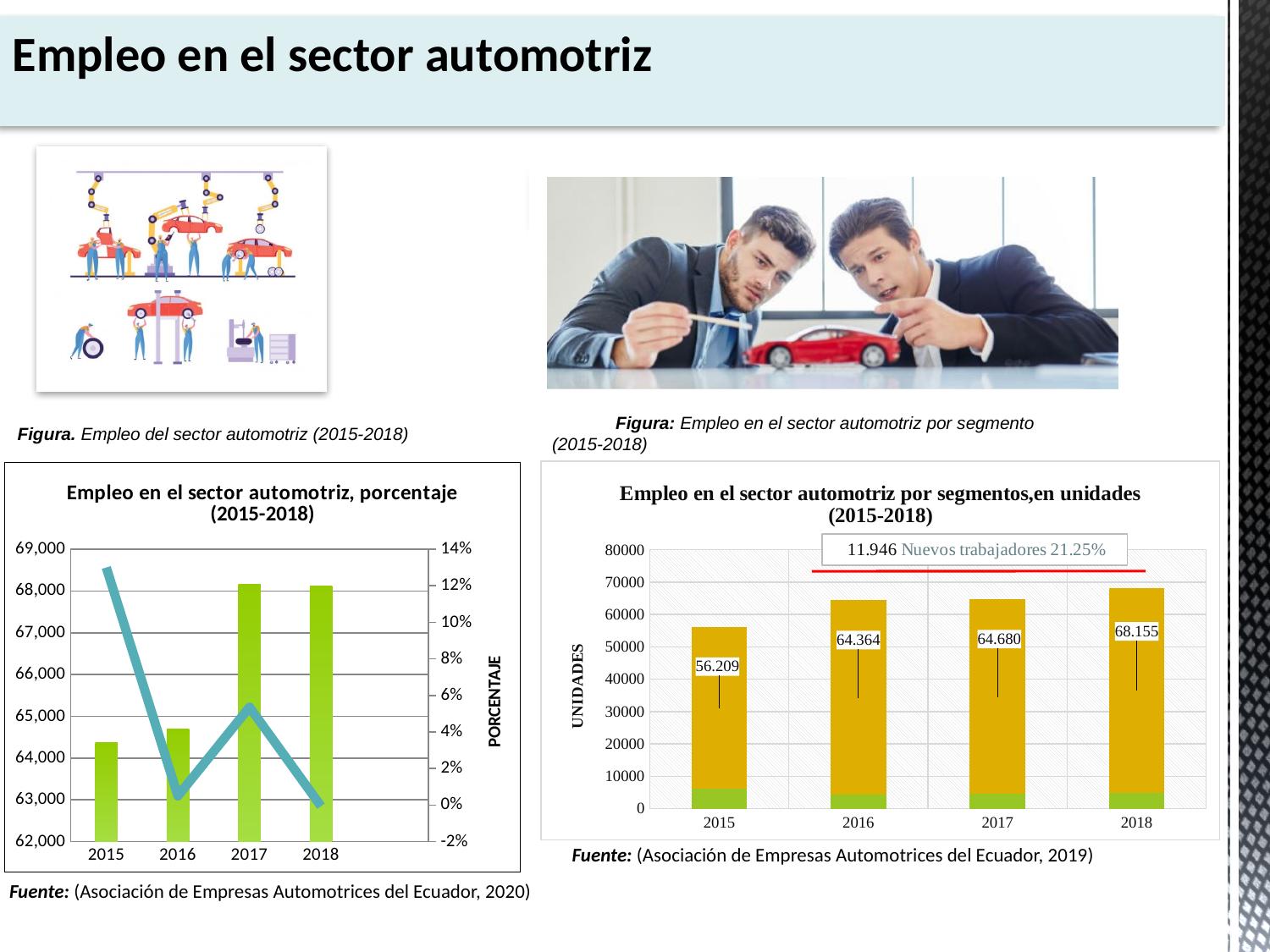
What kind of chart is the chart titled 'Empleo en el sector automotriz por segmentos, en unidades (2015-2018)'? bar chart In the chart 'Empleo en el sector automotriz, porcentaje (2015-2018)', is the bar for 2015 greater or less than 65,000? less In the chart 'Empleo en el sector automotriz por segmentos, en unidades (2015-2018)', what is the difference between the labelled values for 2018 and 2015? 11.946 In the chart 'Empleo en el sector automotriz, porcentaje (2015-2018)', is the line value for 2015 greater or less than 10%? greater How many years are shown on the x axis of the chart 'Empleo en el sector automotriz por segmentos, en unidades (2015-2018)'? 4 In the chart 'Empleo en el sector automotriz por segmentos, en unidades (2015-2018)', what value is labelled for 2015? 56.209 In the chart 'Empleo en el sector automotriz por segmentos, en unidades (2015-2018)', which year has the larger labelled value, 2016 or 2017? 2017 In the chart 'Empleo en el sector automotriz por segmentos, en unidades (2015-2018)', what value is labelled for 2018? 68.155 What is the label on the vertical axis of the chart 'Empleo en el sector automotriz por segmentos, en unidades (2015-2018)'? UNIDADES In the chart 'Empleo en el sector automotriz, porcentaje (2015-2018)', is the bar for 2017 greater or less than 67,000? greater In the chart 'Empleo en el sector automotriz por segmentos, en unidades (2015-2018)', which year has the highest labelled value? 2018 In the chart 'Empleo en el sector automotriz por segmentos, en unidades (2015-2018)', which year has the lowest labelled value? 2015